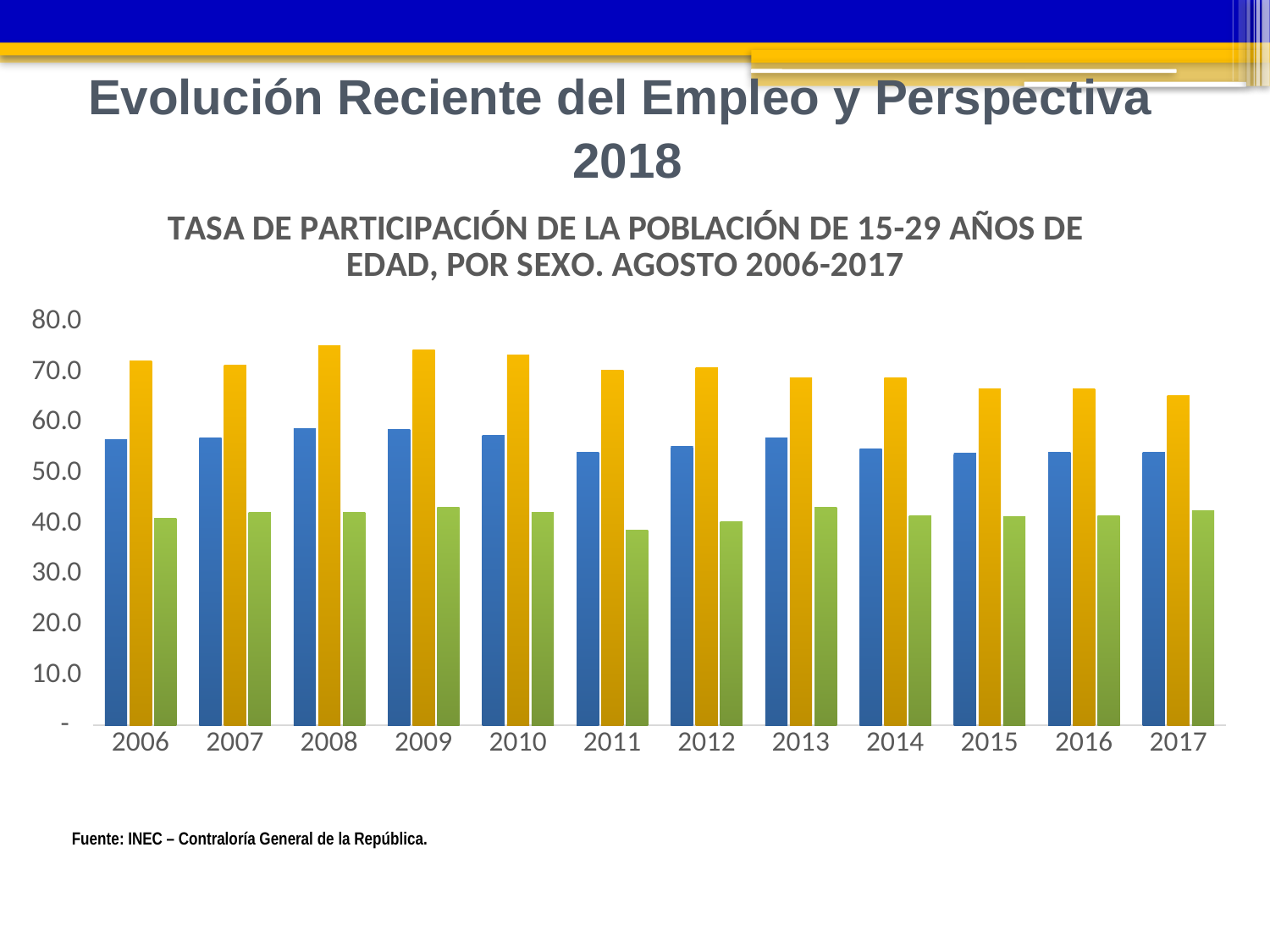
How many years are shown on the x axis of the chart? 12 For 2006, which bar is taller, the blue bar or the yellow bar? the yellow bar What kind of chart is shown on the slide? bar chart Is the value of the blue bar for 2006 greater or less than 50.0? greater In which year is the yellow bar the tallest? 2008 Is the value of the green bar for 2011 greater or less than 40.0? less Do the yellow bars generally rise or fall from 2006 to 2017? fall In which year is the yellow bar the shortest? 2017 Is the value of the yellow bar for 2008 greater or less than 70.0? greater In which year is the green bar the shortest? 2011 How many bars are plotted for each year in the chart? 3